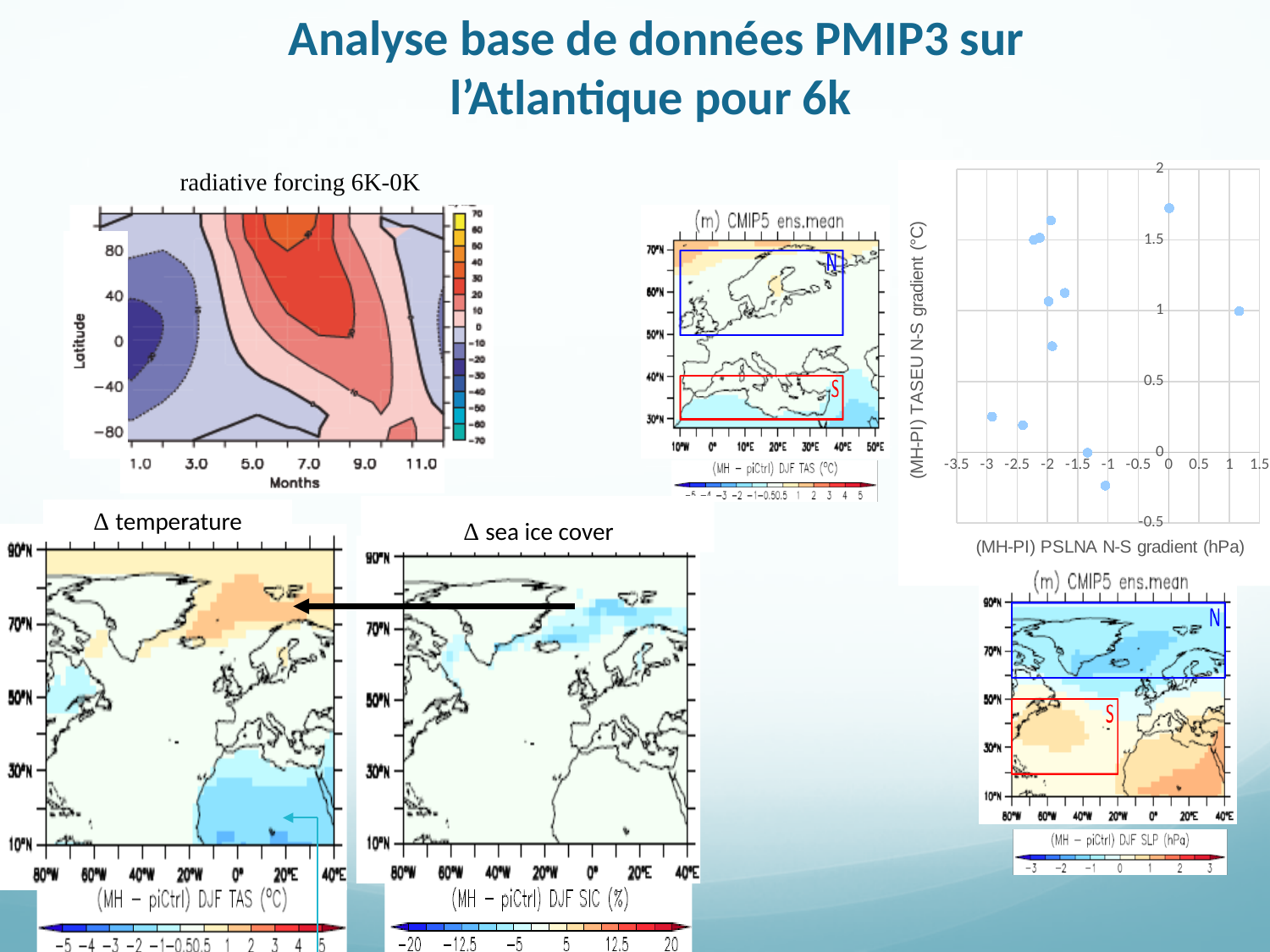
In the scatter chart on the right, is the smallest plotted x value greater or less than -2.5? less What is the x-axis label of the scatter chart on the right of the slide? (MH-PI) PSLNA N-S gradient (hPa) In the scatter chart on the right, is the largest plotted x value greater or less than 1? greater In the scatter chart on the right, is the lowest plotted y value greater or less than 0? less What kind of chart is the chart on the right with axes labelled in hPa and °C? scatter chart What is the y-axis label of the scatter chart on the right of the slide? (MH-PI) TASEU N-S gradient (°C) In the scatter chart on the right, which has the larger y value: the point near x = 0 or the point near x = 1.2? the point near x = 0 In the scatter chart on the right, are most of the plotted points at negative or positive x values? negative